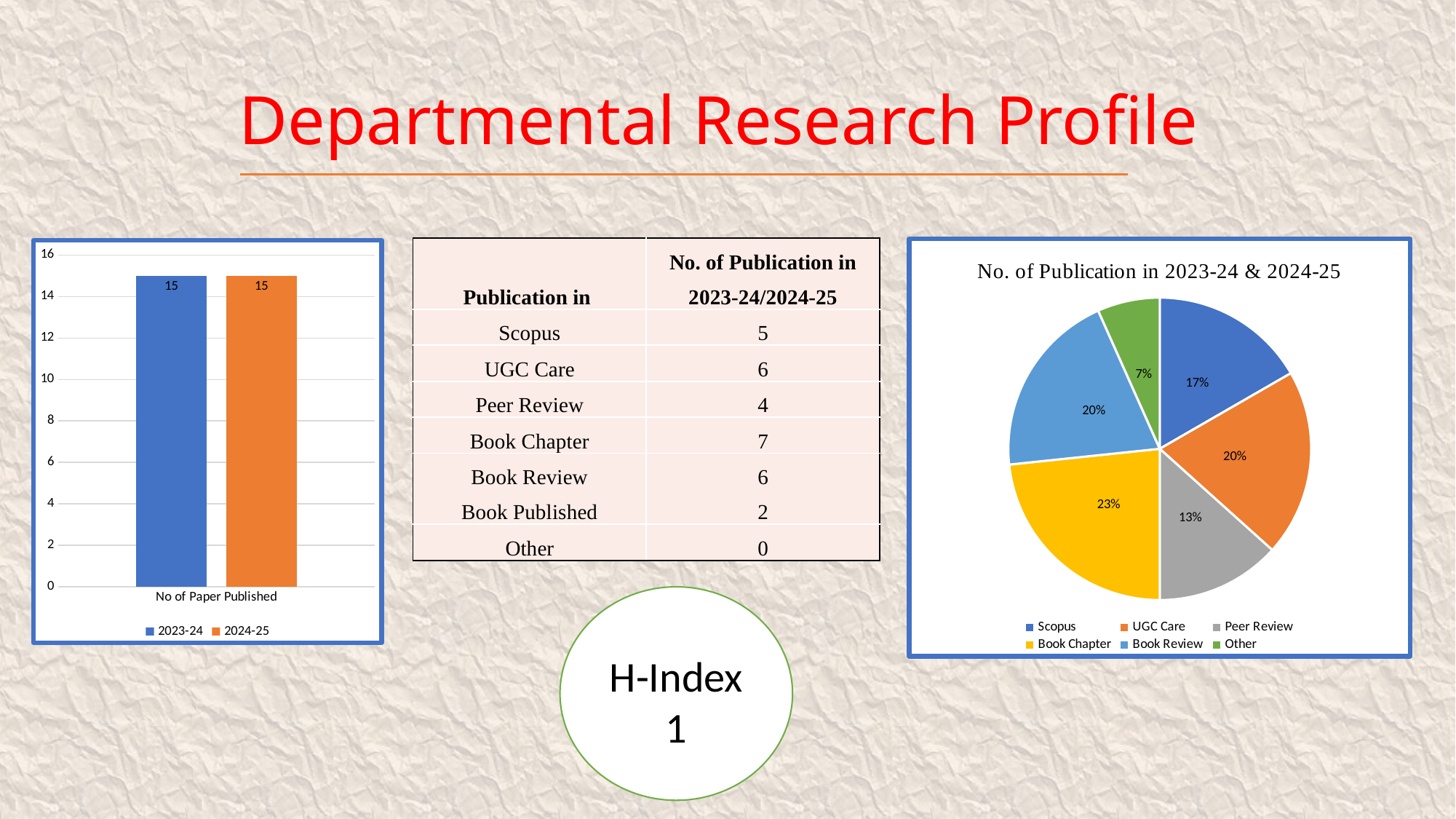
In the pie chart titled 'No. of Publication in 2023-24 & 2024-25', which category has the largest slice? Book Chapter In the bar chart on the left, how many series does the legend list? 2 In the pie chart titled 'No. of Publication in 2023-24 & 2024-25', what share does Scopus have? 17% In the bar chart on the left, what is the difference between the 2023-24 and 2024-25 values? 0 What kind of chart is the chart on the left of the slide? bar chart In the bar chart on the left, what is the value for 2024-25? 15 In the bar chart on the left, what is the value for 2023-24? 15 In the pie chart on the right, what colour is the Book Chapter slice? yellow In the pie chart titled 'No. of Publication in 2023-24 & 2024-25', which is larger, Peer Review or UGC Care? UGC Care In the pie chart titled 'No. of Publication in 2023-24 & 2024-25', how many slices are there? 6 In the pie chart titled 'No. of Publication in 2023-24 & 2024-25', which category has the smallest slice? Other In the pie chart titled 'No. of Publication in 2023-24 & 2024-25', what share does Book Chapter have? 23%